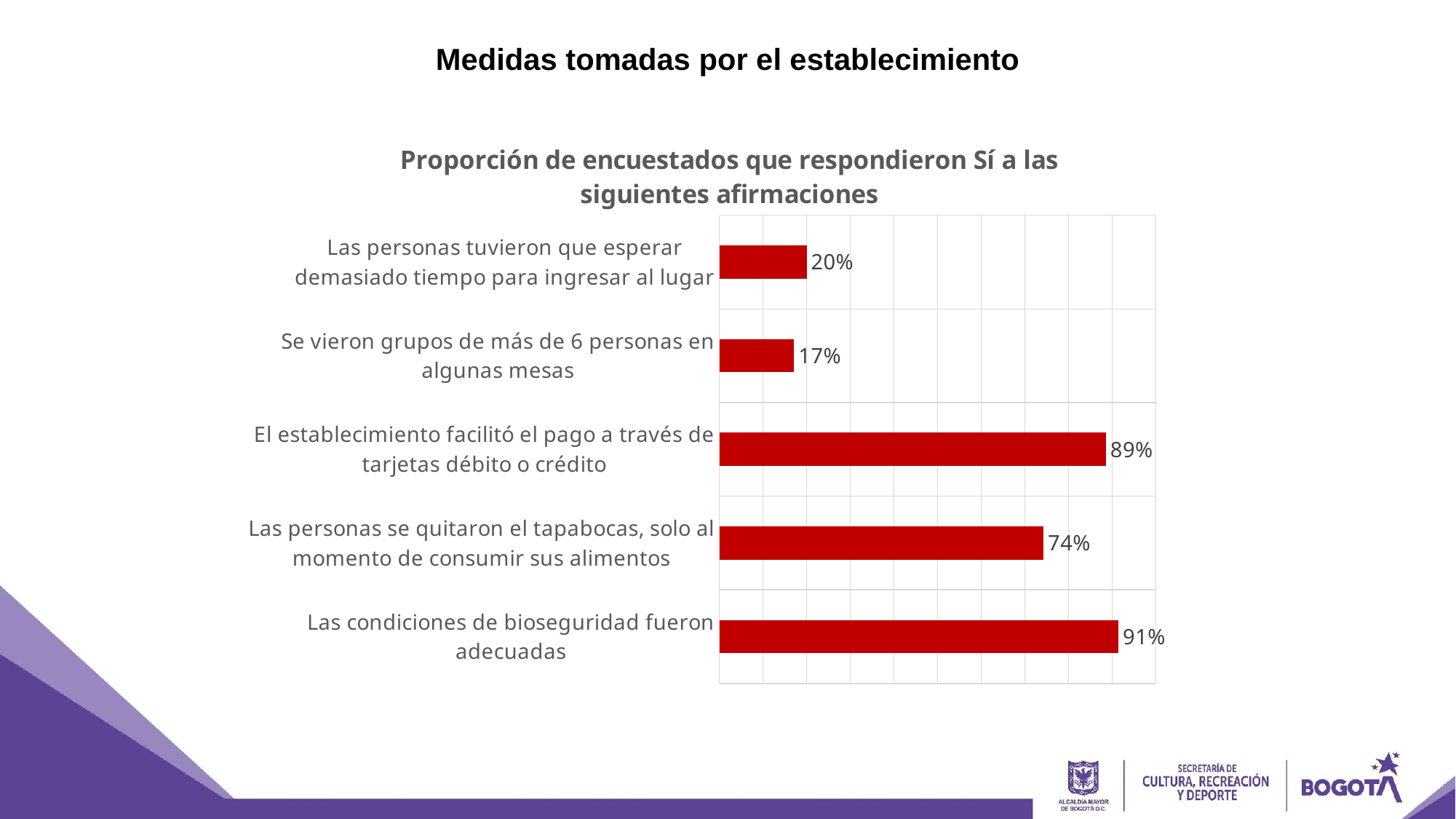
What is the title of the chart? Proporción de encuestados que respondieron Sí a las siguientes afirmaciones What is the value for 'Las personas se quitaron el tapabocas, solo al momento de consumir sus alimentos'? 74% What is the value for 'El establecimiento facilitó el pago a través de tarjetas débito o crédito'? 89% Which statement has the highest proportion of 'Sí' responses? Las condiciones de bioseguridad fueron adecuadas What percentage of respondents said 'Las condiciones de bioseguridad fueron adecuadas'? 91% Which statement has the lowest proportion of 'Sí' responses? Se vieron grupos de más de 6 personas en algunas mesas What is the difference between the values for 'Las condiciones de bioseguridad fueron adecuadas' and 'Las personas se quitaron el tapabocas, solo al momento de consumir sus alimentos'? 17% Which is larger: the value for 'El establecimiento facilitó el pago a través de tarjetas débito o crédito' or the value for 'Las personas se quitaron el tapabocas, solo al momento de consumir sus alimentos'? El establecimiento facilitó el pago a través de tarjetas débito o crédito What is the difference between the values for 'Las personas tuvieron que esperar demasiado tiempo para ingresar al lugar' and 'Se vieron grupos de más de 6 personas en algunas mesas'? 3% What is the value for 'Se vieron grupos de más de 6 personas en algunas mesas'? 17% How many statements are shown in the chart? 5 What kind of chart is shown on the slide? Bar chart